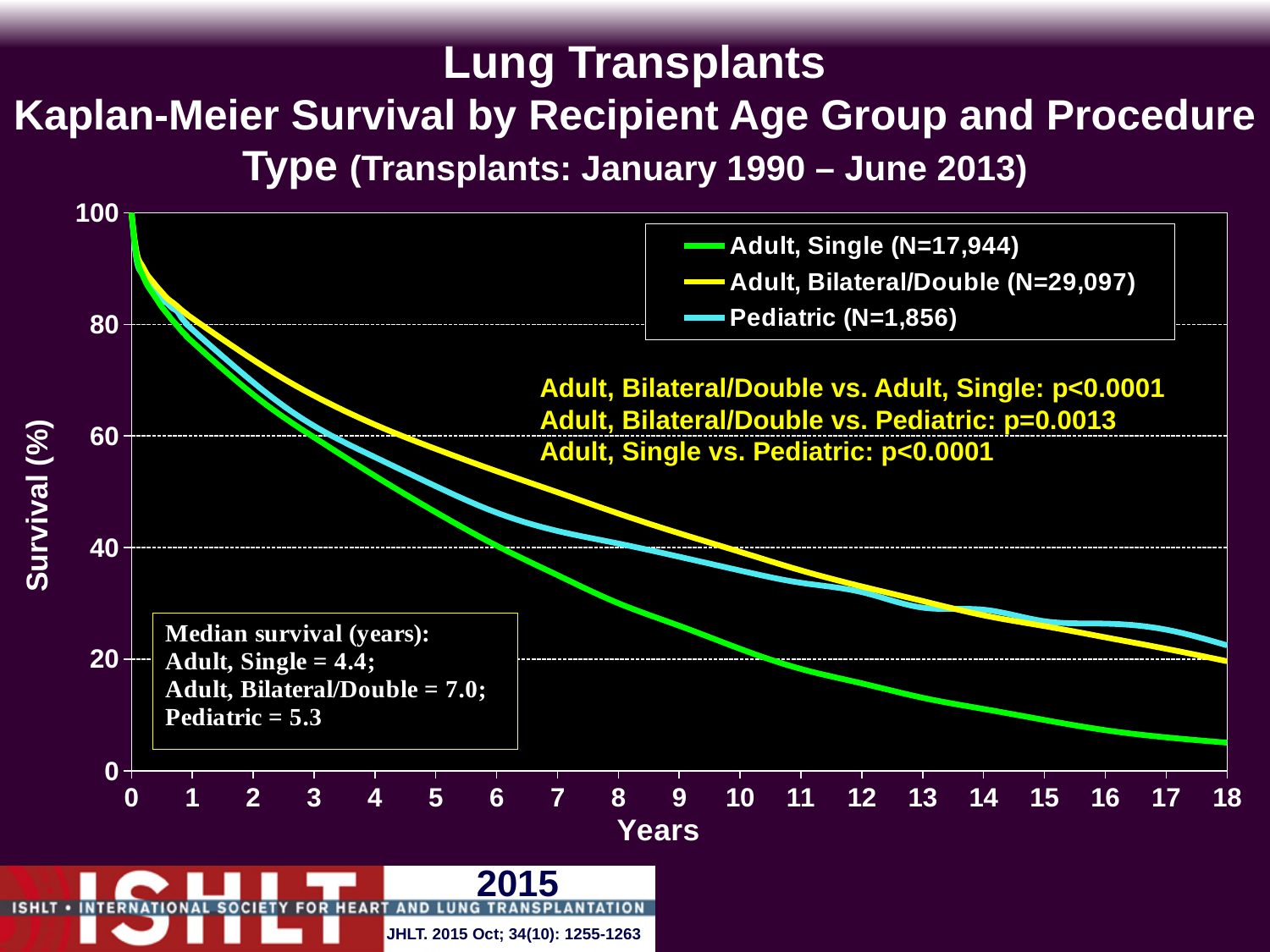
Is the survival for Adult, Bilateral/Double at 2 years greater or less than 80? less What kind of chart is shown on the slide? line chart Which group has the lowest median survival? Adult, Single What is the median survival in years for Adult, Bilateral/Double recipients? 7.0 What is the N for the Pediatric group shown in the legend? 1,856 Do the survival curves rise or fall as years increase? fall Is the survival for Adult, Single at 18 years greater or less than 20? less How many series does the legend list? 3 At 5 years, which group has the highest survival? Adult, Bilateral/Double What is the difference in median survival (years) between Adult, Bilateral/Double and Adult, Single? 2.6 Which group has the largest N in the legend? Adult, Bilateral/Double What is the median survival in years for Pediatric recipients? 5.3